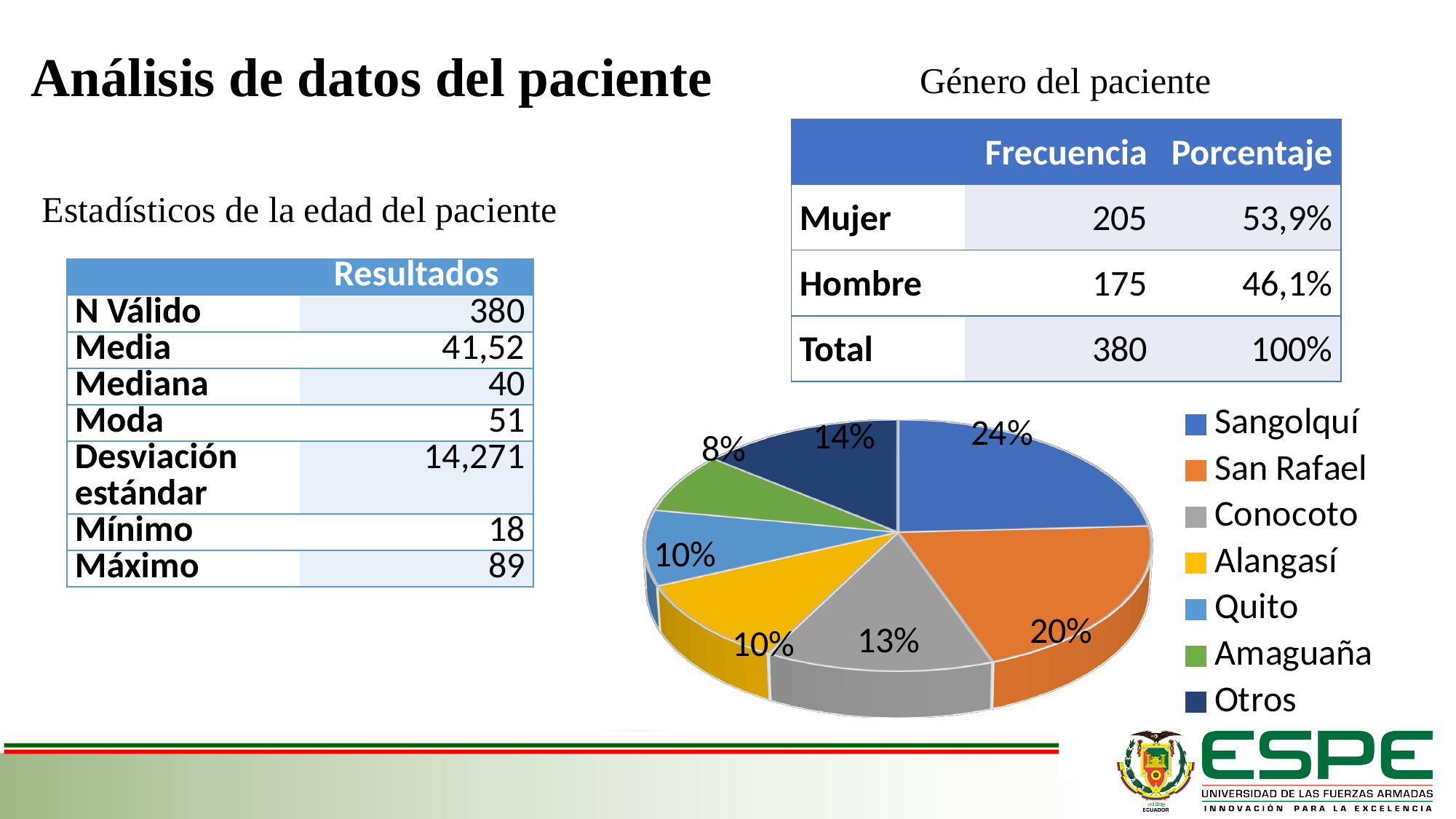
In the pie chart, what share does Conocoto have? 13% In the pie chart, what share does San Rafael have? 20% In the pie chart, what share does Sangolquí have? 24% Which category has the smallest slice in the pie chart? Amaguaña Which category has the largest slice in the pie chart? Sangolquí In the pie chart, which is larger: San Rafael or Conocoto? San Rafael How many categories does the pie chart's legend list? 7 In the pie chart, what colour is the Alangasí slice? yellow What kind of chart is shown on the slide? pie chart In the pie chart, what is the difference between the shares of Sangolquí and Otros? 10%